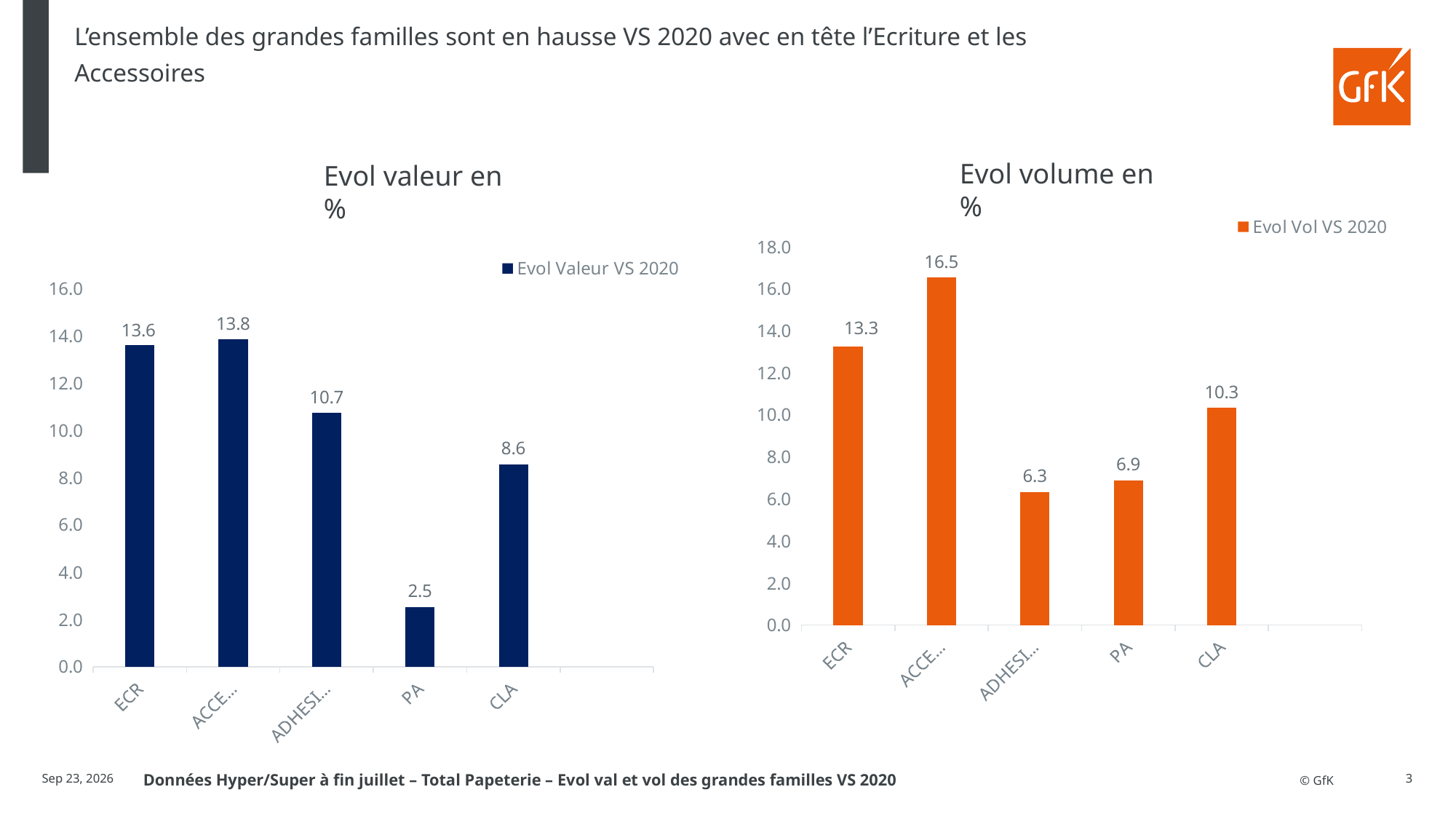
In the 'Evol volume en %' chart, what is the value for PA? 6.9 In the 'Evol valeur en %' chart, is the value for CLA greater or less than 10.0? less What is the legend entry shown in the 'Evol volume en %' chart? Evol Vol VS 2020 In the 'Evol valeur en %' chart, what is the value for ECR? 13.6 In the 'Evol valeur en %' chart, what is the difference between the values for ECR and CLA? 5.0 In the 'Evol valeur en %' chart, which category has the lowest value? PA In the 'Evol valeur en %' chart, what is the value for PA? 2.5 In the 'Evol volume en %' chart, what is the value for CLA? 10.3 In the 'Evol volume en %' chart, what is the difference between the values for ECR and PA? 6.4 How many categories are shown in the 'Evol volume en %' chart? 5 In the 'Evol volume en %' chart, which is larger, the value for CLA or the value for PA? CLA What type of chart is the 'Evol valeur en %' chart? bar chart